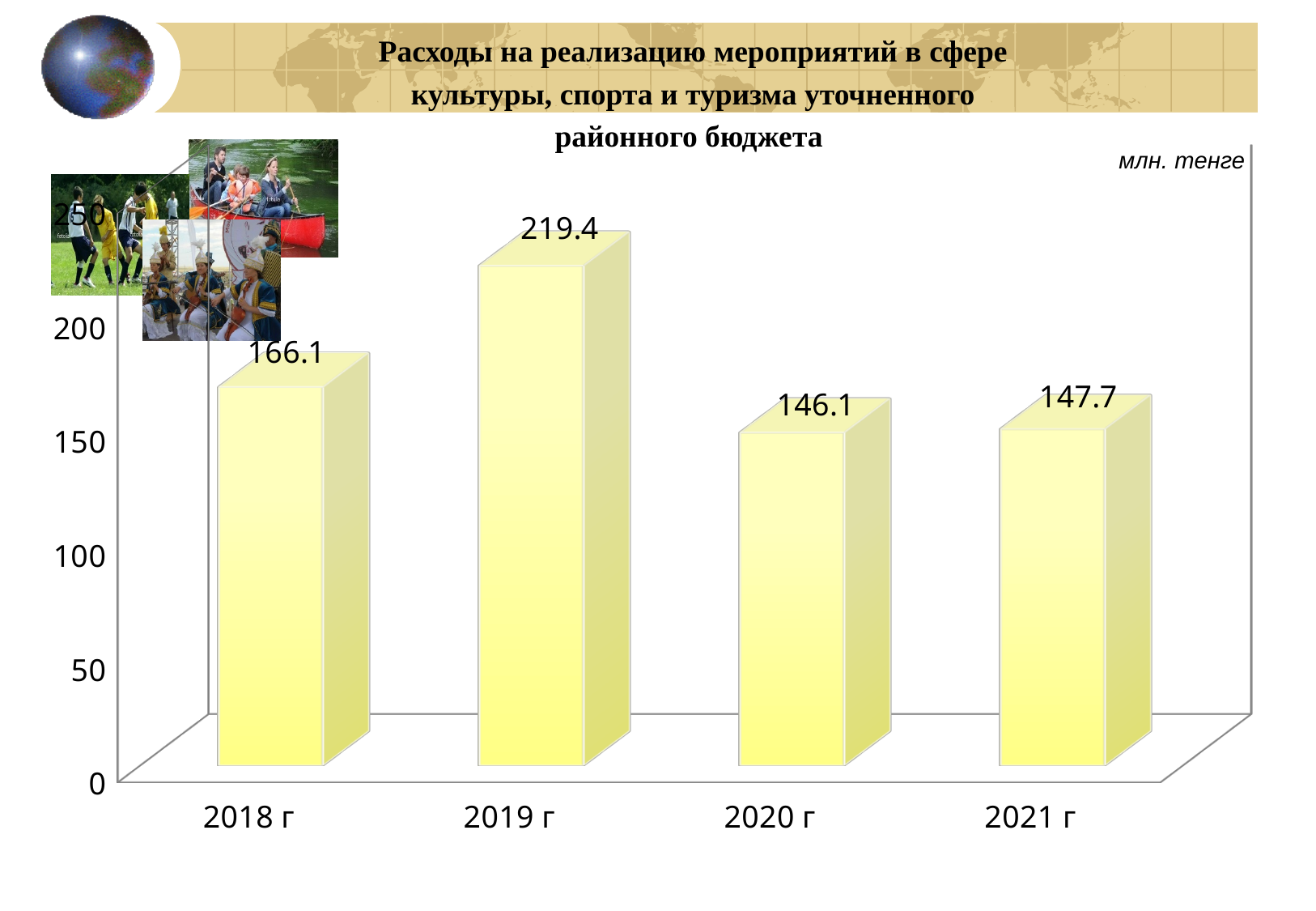
Which is larger, the value for 2018 г or the value for 2021 г? 2018 г Which year has the lowest value? 2020 г Is the value for 2019 г greater or less than 200? greater What is the value for 2018 г? 166.1 Which year has the highest value? 2019 г What kind of chart is shown on the slide? bar chart What is the value for 2020 г? 146.1 What unit is indicated for the values on the chart? млн. тенге What is the value for 2021 г? 147.7 What is the difference between the values for 2019 г and 2018 г? 53.3 What is the value for 2019 г? 219.4 How many years are shown on the chart? 4